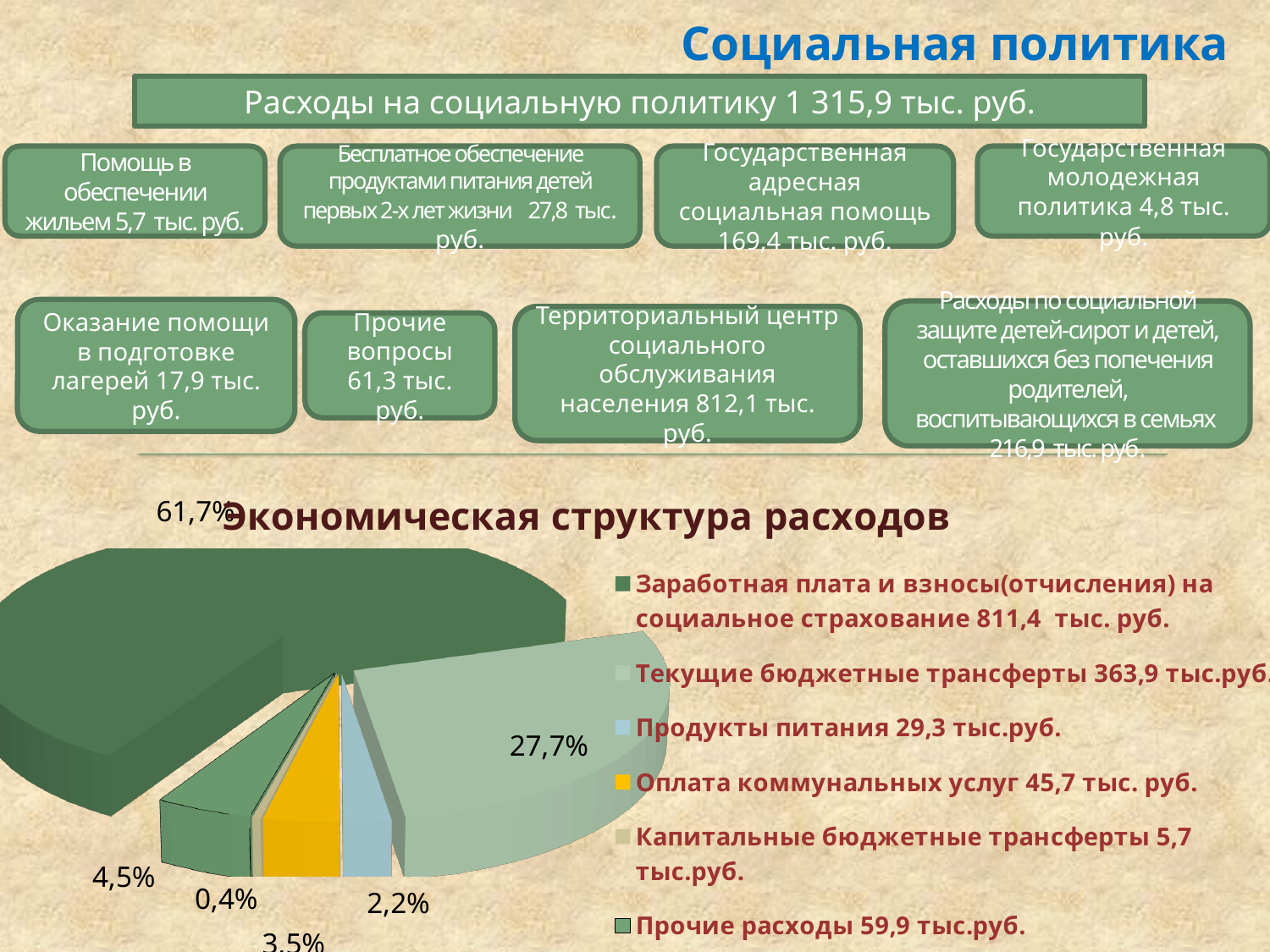
Which category has the smallest slice of the pie chart? Капитальные бюджетные трансферты What amount is shown in the legend for "Прочие расходы"? 59,9 тыс.руб. Which category has the largest slice of the pie chart? Заработная плата и взносы(отчисления) на социальное страхование What amount is shown in the legend for "Продукты питания"? 29,3 тыс.руб. What share of the pie does "Оплата коммунальных услуг" take? 3,5% What share of the pie does "Капитальные бюджетные трансферты" take? 0,4% Which slice is larger: "Прочие расходы" or "Продукты питания"? Прочие расходы What share of the pie does "Заработная плата и взносы(отчисления) на социальное страхование" take? 61,7% How many categories does the legend of the pie chart list? 6 What is the difference in percentage points between the "Заработная плата" slice (61,7%) and the "Текущие бюджетные трансферты" slice (27,7%)? 34 percentage points What kind of chart is shown under the heading "Экономическая структура расходов"? pie chart